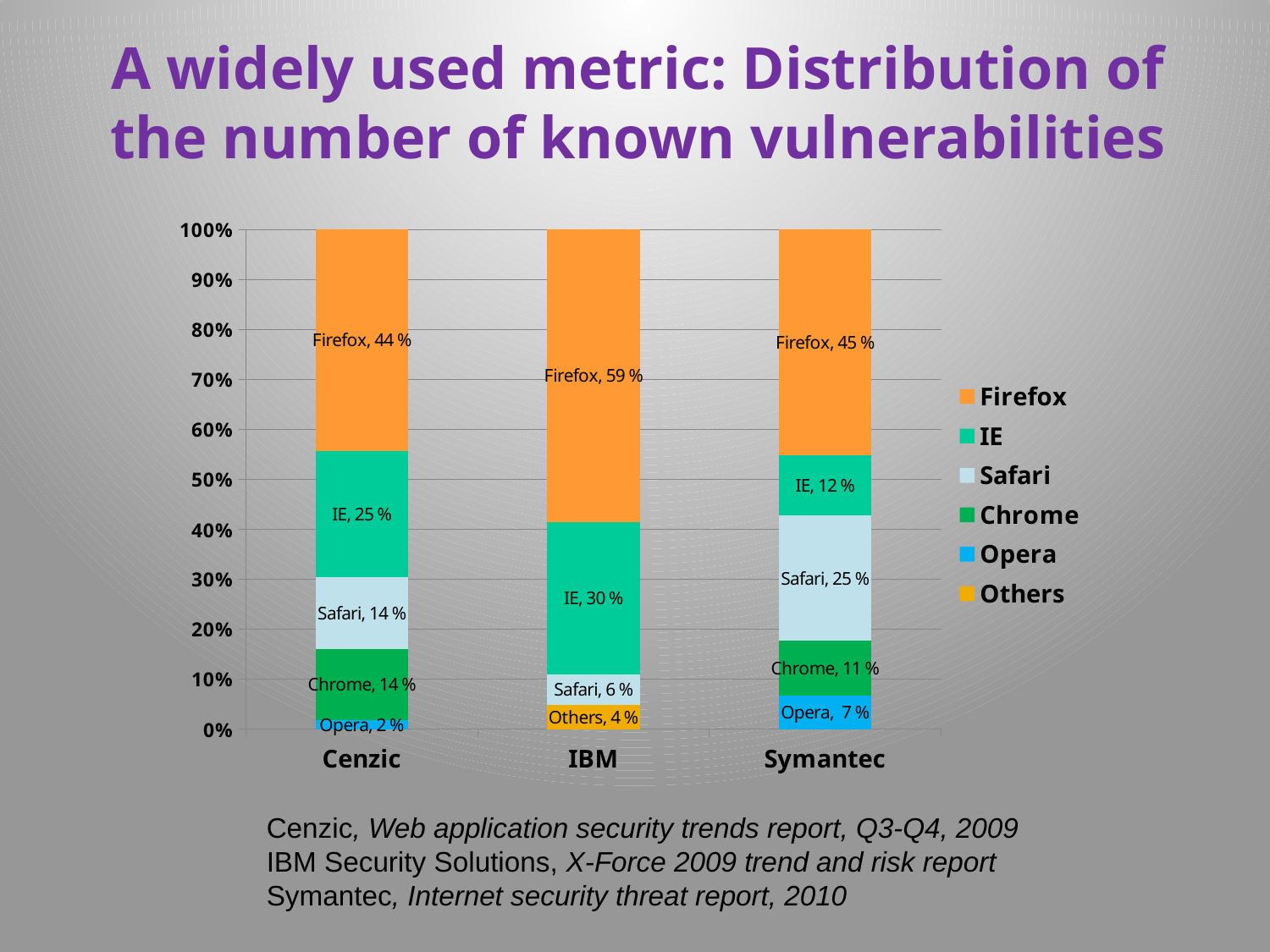
Which source reports the lowest IE share? Symantec How many series does the legend list? 6 What is the difference between the IE shares for Cenzic and Symantec? 13 % What kind of chart is shown on the slide? Stacked bar chart Which source reports the highest Firefox share? IBM What is the Others share for IBM? 4 % Which colour represents Firefox in the chart? Orange How many sources (categories) are shown on the x axis? 3 Is the Safari share larger for IBM or for Symantec? Symantec What is the Opera share for Cenzic? 2 % What is the Firefox share for IBM? 59 % What is the Safari share for Symantec? 25 %